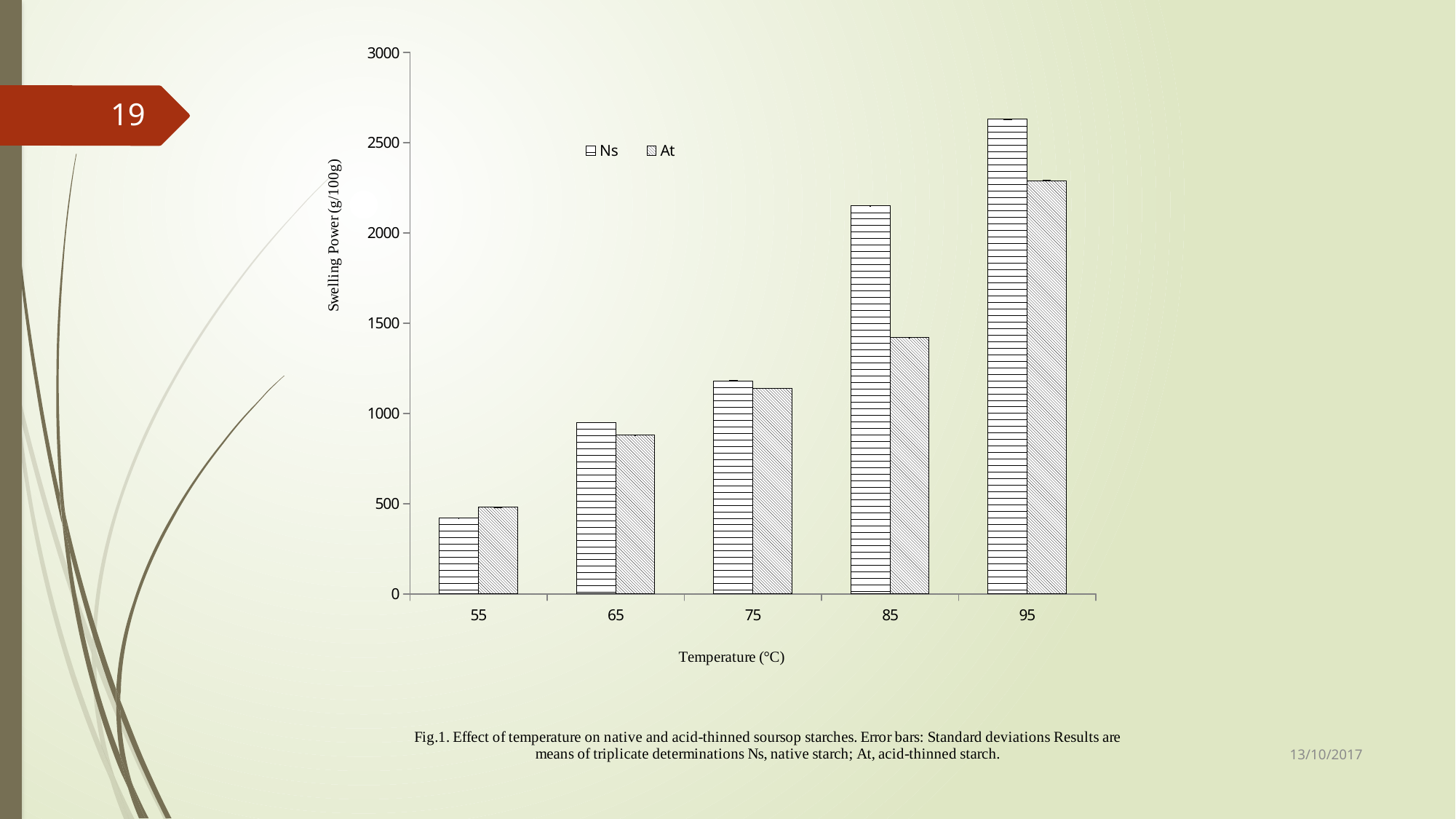
Is the Ns value at 55 °C greater or less than 500? less At which temperature is the Ns swelling power lowest? 55 Is the Ns value at 95 °C greater or less than 2500? greater What kind of chart is shown on the slide? bar chart At which temperature is the Ns swelling power highest? 95 Is the At value at 95 °C greater or less than 2000? greater What is the label of the y axis? Swelling Power (g/100g) At 85 °C, which series has the larger swelling power, Ns or At? Ns Does the Ns swelling power rise or fall as temperature increases from 55 to 95 °C? rise How many series does the legend list? 2 How many temperature categories are shown on the x axis? 5